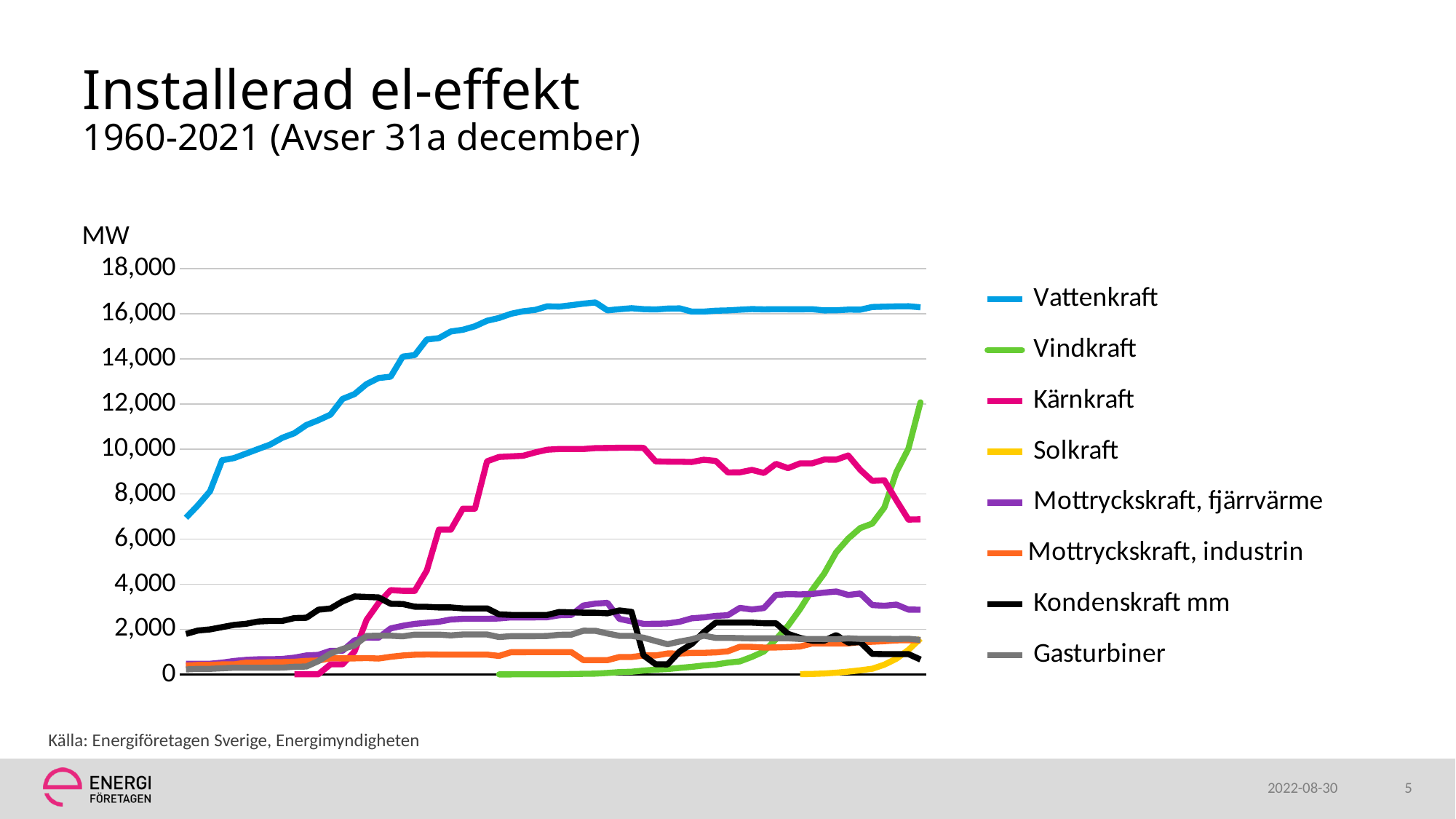
Does the Vattenkraft line overall rise or fall from left to right? rise Which series has the highest values throughout the chart? Vattenkraft Which series has the lowest value at the right end of the chart? Kondenskraft mm Is the final value for Vattenkraft greater or less than 14,000? greater Does the Vindkraft line rise or fall toward the right end of the chart? rise Is the final value for Vindkraft greater or less than 10,000? greater At the right end of the chart, which is larger: Vindkraft or Kärnkraft? Vindkraft Is the final value for Solkraft greater or less than 2,000? less What is the title of the chart on the slide? Installerad el-effekt How many series does the legend list? 8 What kind of chart is shown on the slide? line chart What unit is shown on the y axis of the chart? MW